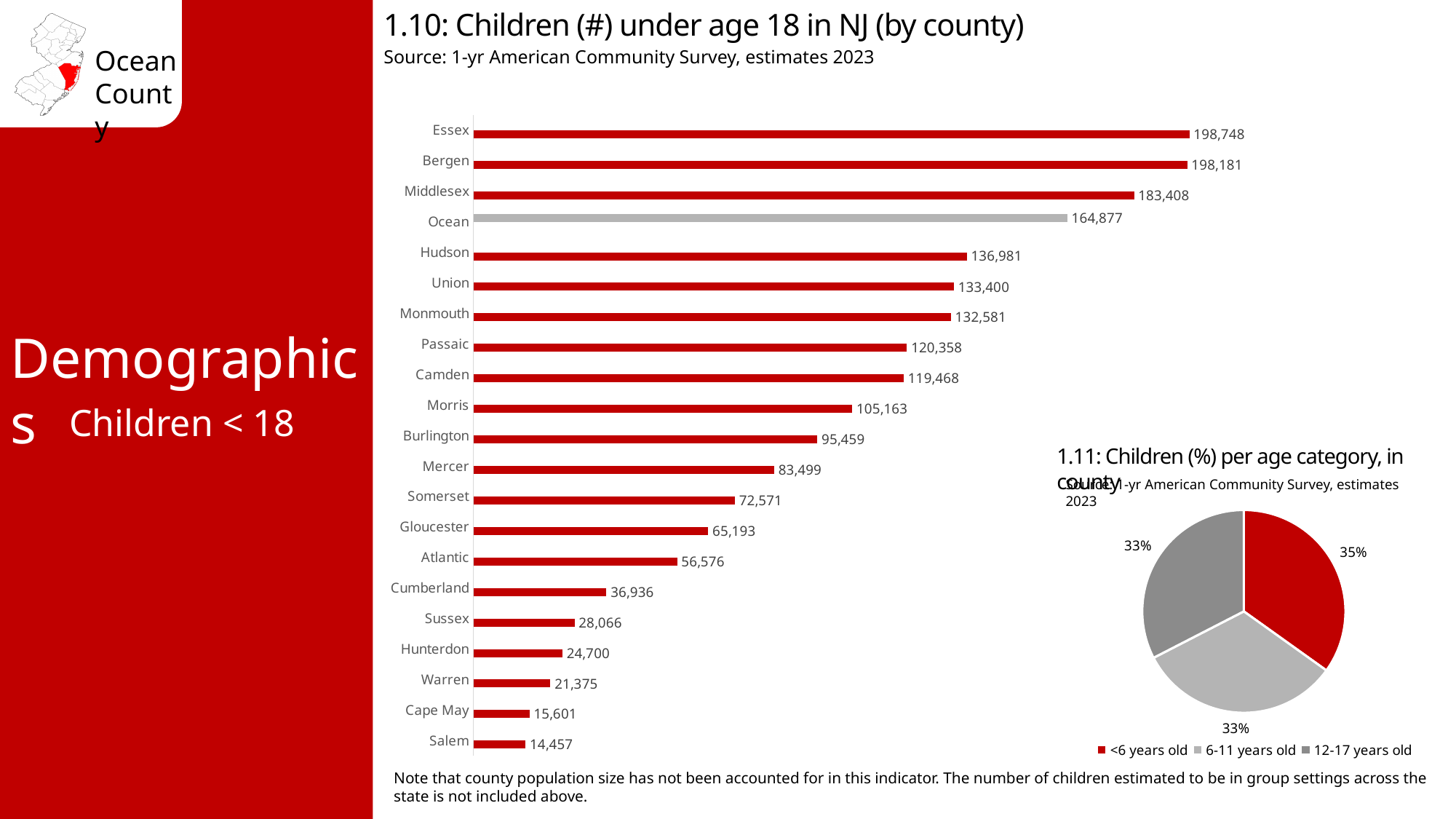
In chart 1.10, which county has more children under 18, Passaic or Camden? Passaic In chart 1.10, what is the value for Hudson County? 136,981 In chart 1.10 (Children under age 18 in NJ by county), how many children under 18 are in Ocean County? 164,877 In chart 1.11 (Children (%) per age category), what share of children are under 6 years old? 35% In chart 1.10, how many counties are shown? 21 In chart 1.10, what is the value for Cape May? 15,601 In chart 1.10, which county has the lowest number of children under 18? Salem What type of chart is chart 1.10? Bar chart In chart 1.10, which county's bar is shown in grey rather than red? Ocean In chart 1.11, how many age categories does the legend list? 3 In chart 1.10, what is the difference between the values for Essex and Ocean? 33,871 In chart 1.10, which county has the highest number of children under 18? Essex